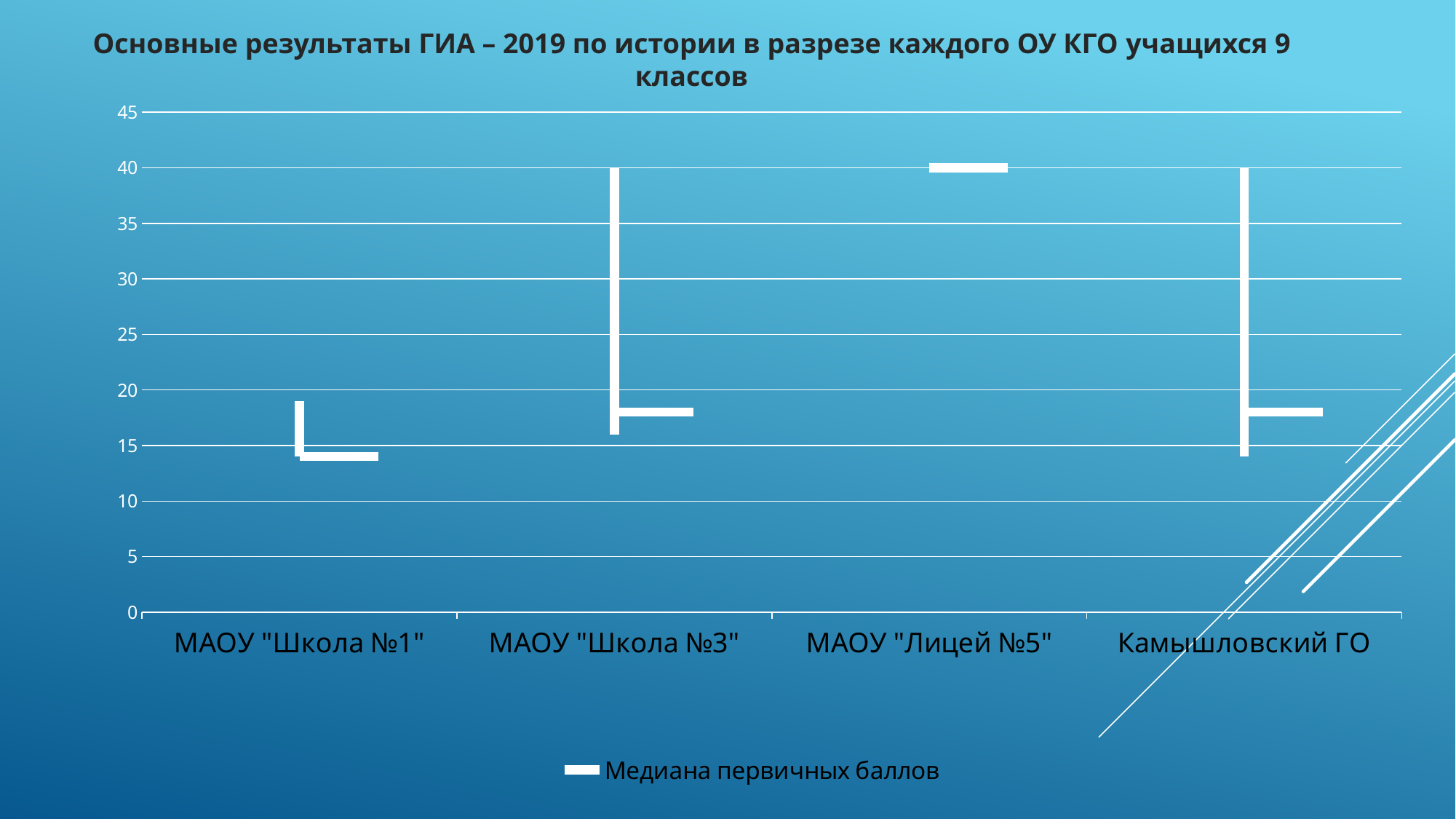
Is the median value for МАОУ "Лицей №5" greater or less than 35? greater Is the median value for МАОУ "Школа №3" greater or less than 15? greater Which category has the lowest median value (Медиана первичных баллов)? МАОУ "Школа №1" How many series does the legend list? 1 What is the name of the series listed in the legend? Медиана первичных баллов Is the median value for Камышловский ГО greater or less than 20? less Which has the larger median value: МАОУ "Лицей №5" or МАОУ "Школа №1"? МАОУ "Лицей №5" Which has the larger median value: МАОУ "Школа №3" or МАОУ "Школа №1"? МАОУ "Школа №3" How many categories are shown on the x axis of the chart? 4 Which category has the highest median value (Медиана первичных баллов)? МАОУ "Лицей №5" What is the maximum value shown on the vertical axis? 45